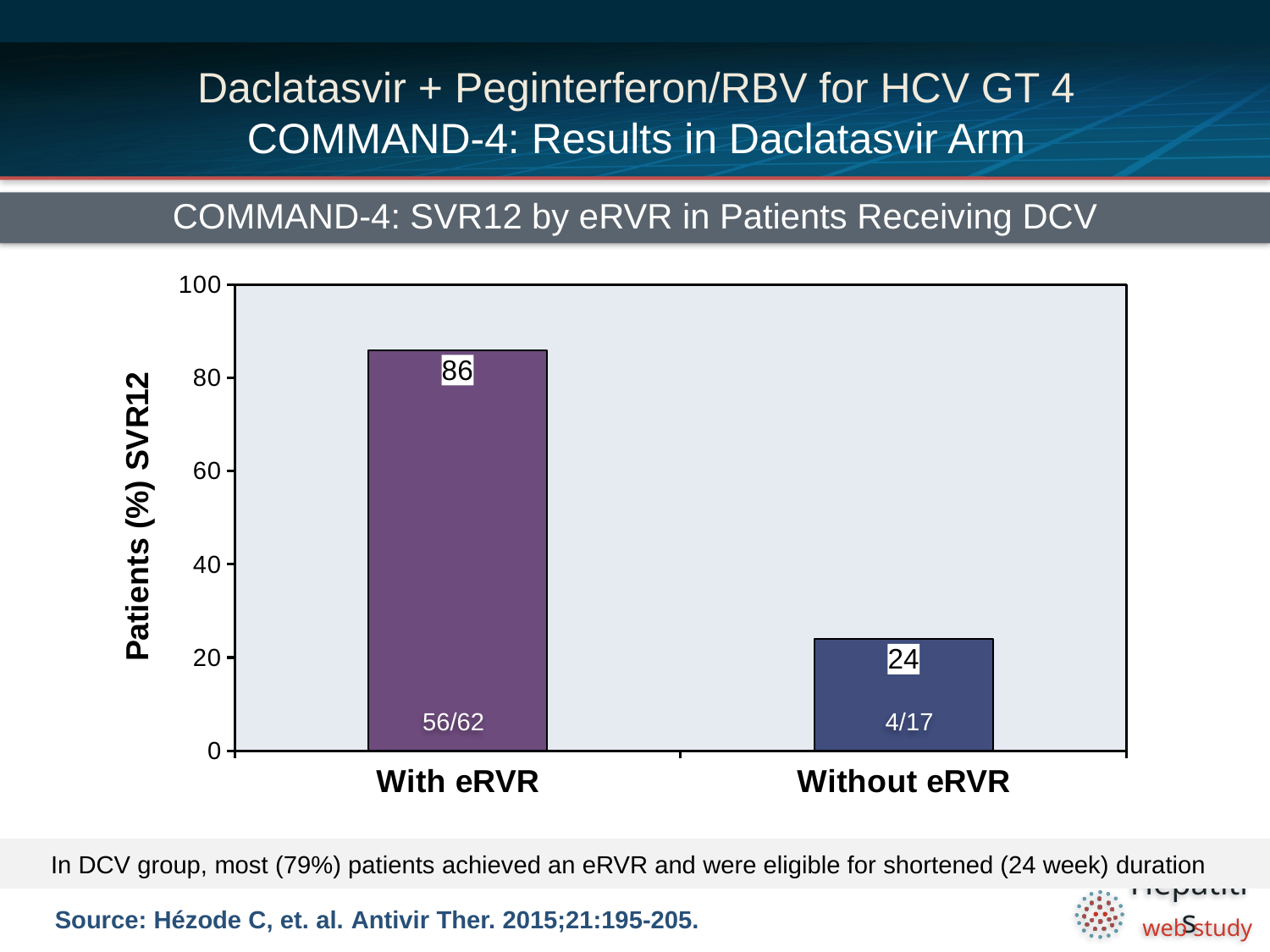
What fraction of patients is shown inside the With eRVR bar? 56/62 What is the SVR12 rate for patients without eRVR? 24 What kind of chart is shown on the slide? Bar chart Is the value for Without eRVR greater or less than 40? less Which category has the highest SVR12 rate? With eRVR What fraction of patients is shown inside the Without eRVR bar? 4/17 Which category has the lowest SVR12 rate? Without eRVR How many categories are shown on the x axis? 2 What is the label of the y axis? Patients (%) SVR12 What is the SVR12 rate for patients with eRVR? 86 What is the difference in SVR12 rate between patients with eRVR and without eRVR? 62 Is the SVR12 rate higher for patients with eRVR or without eRVR? With eRVR